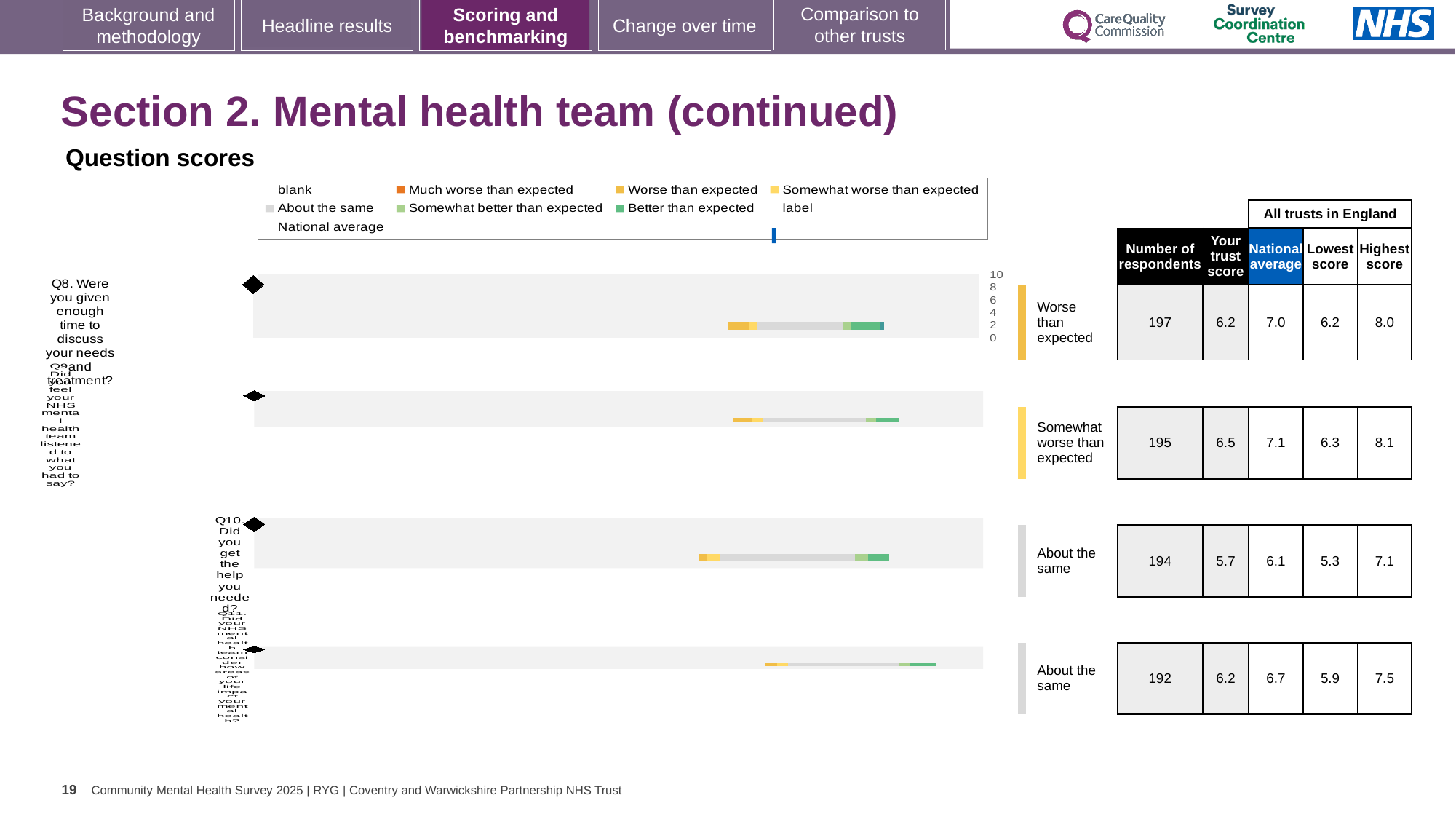
What is the highest score among all trusts in England for Q9? 8.1 How many questions (Q8 to Q11) are plotted on the slide? 4 Which question has the highest 'Your trust score'? Q9 How many respondents answered Q9? 195 Which question has the lowest 'Your trust score'? Q10 What is the lowest score among all trusts in England for Q10? 5.3 What is the difference between the national average and the trust score for Q8? 0.8 What is the national average score for Q8? 7.0 What is the 'Your trust score' for Q8 (Were you given enough time to discuss your needs and treatment?)? 6.2 What kind of chart is used to show the question scores on this slide? bar chart What benchmark category is shown for Q10 (Did you get the help you needed?)? About the same Which is larger: the trust score for Q9 or the trust score for Q11? Q9